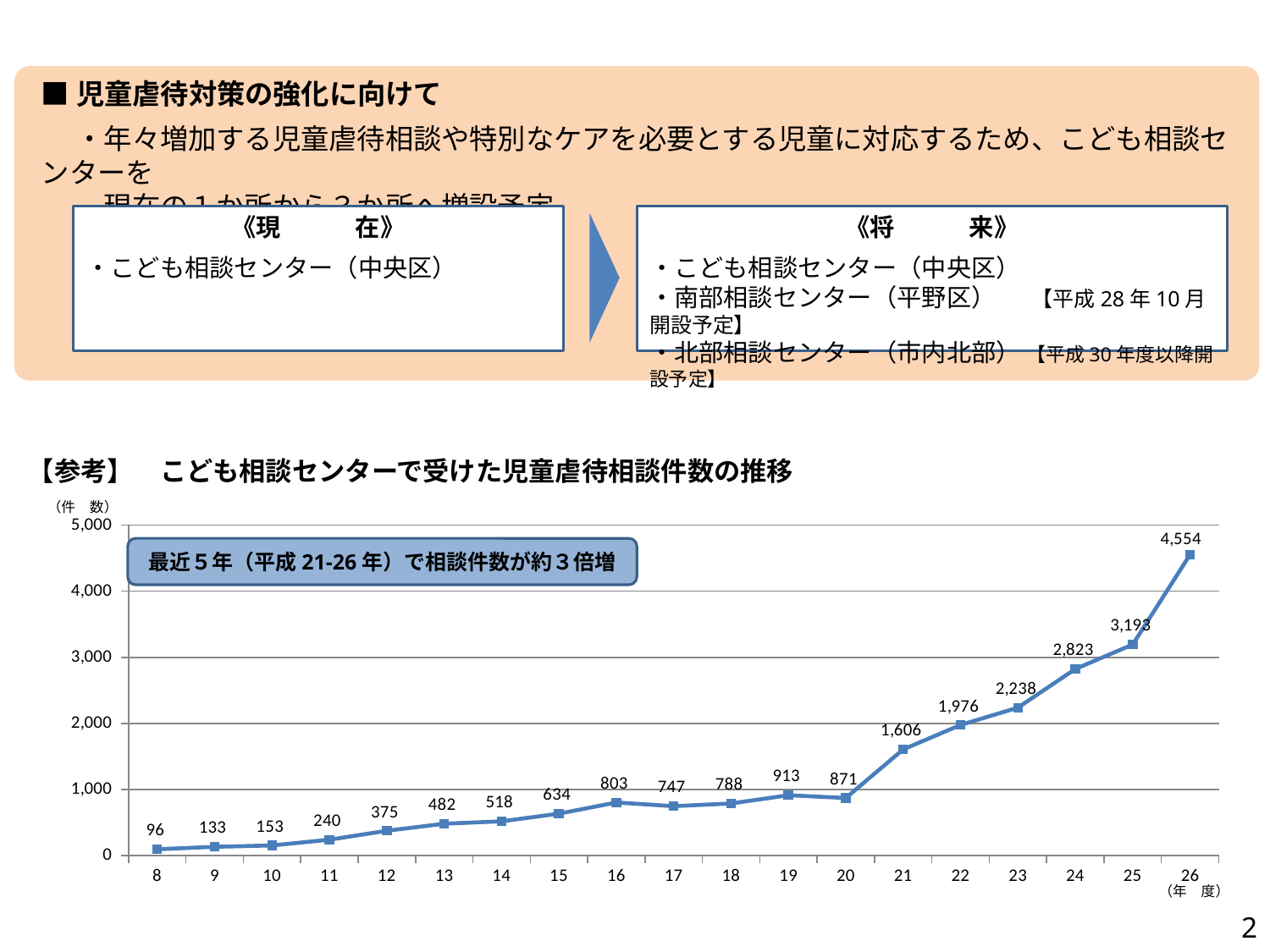
Which fiscal year has the highest number of consultations? 26 Which fiscal year has more consultations, 19 or 20? 19 What kind of chart is shown on the slide? line chart Which fiscal year has more consultations, 16 or 17? 16 What is the title of the chart? こども相談センターで受けた児童虐待相談件数の推移 What is the difference in consultations between fiscal year 26 and fiscal year 25? 1,361 What is the number of consultations (件数) for fiscal year 26? 4,554 How many fiscal years are plotted on the chart? 19 What is the number of consultations for fiscal year 8? 96 Do the consultation counts generally rise or fall from fiscal year 8 to fiscal year 26? rise What is the number of consultations for fiscal year 21? 1,606 Which fiscal year has the lowest number of consultations? 8